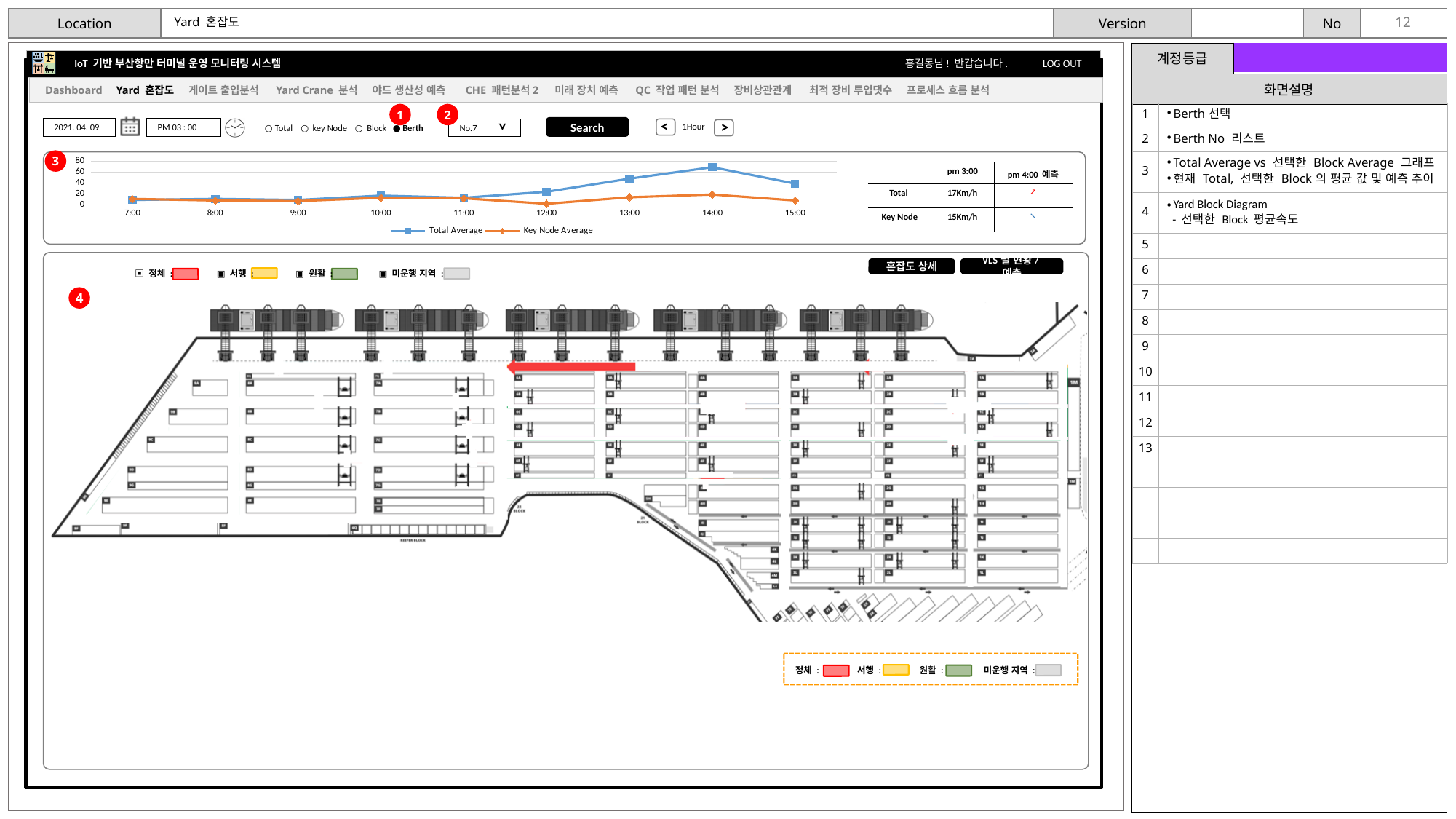
How many time points are plotted along the x axis of the line chart? 9 What are the two series named in the line chart's legend? Total Average and Key Node Average Does the Total Average series rise or fall between 12:00 and 14:00? rise At which time does the Total Average series reach its highest value? 14:00 Is the Key Node Average value at 14:00 greater or less than 40? less Is the Total Average value at 12:00 greater or less than 40? less What kind of chart is shown at the top of the dashboard? line chart Which colour is used for the Total Average line in the chart? blue At 14:00, which series has the larger value, Total Average or Key Node Average? Total Average Is the Total Average value at 14:00 greater or less than 60? greater At which time does the Key Node Average series reach its highest value? 14:00 How many series does the legend of the line chart list? 2